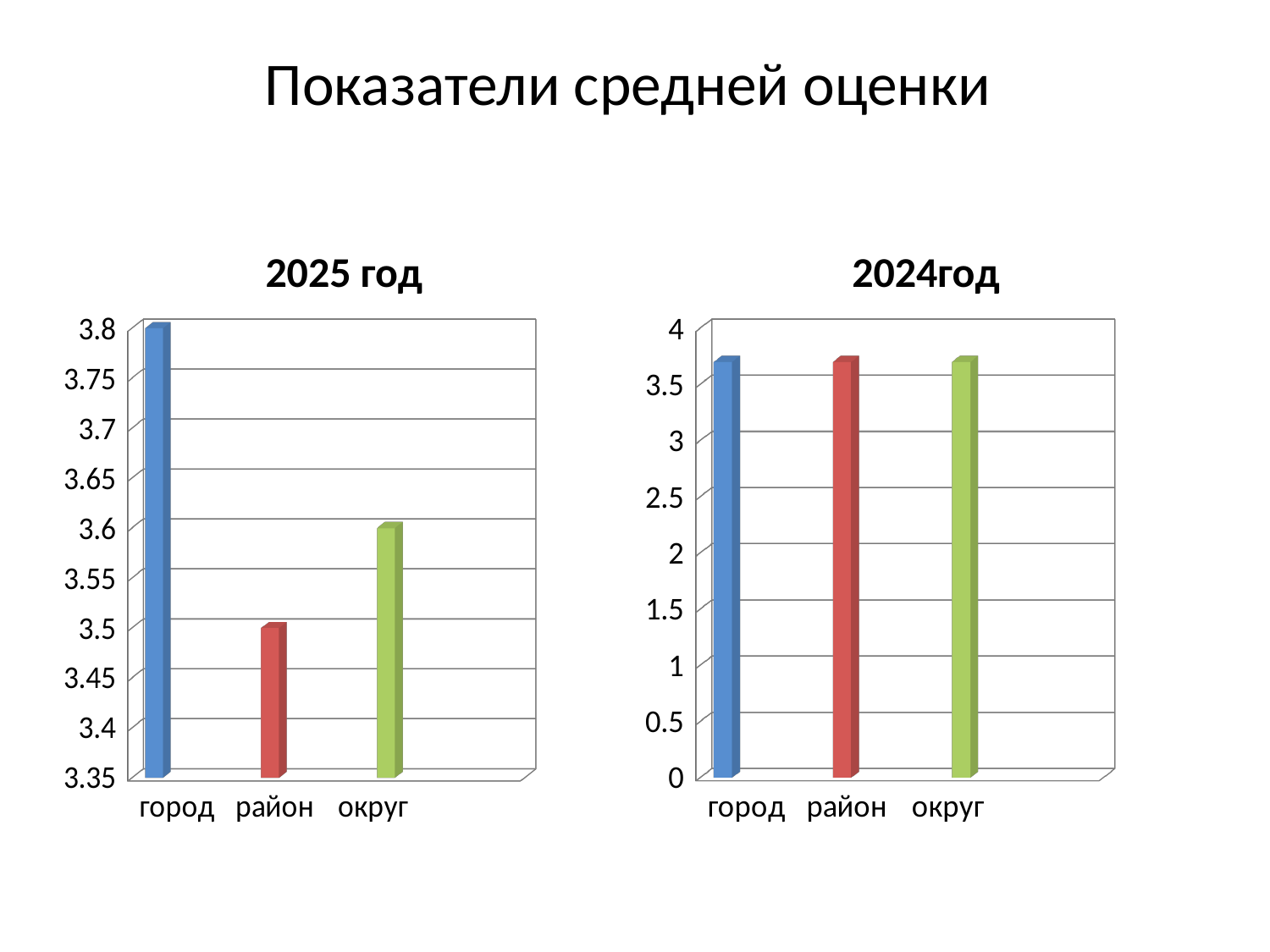
In the chart titled "2025 год", what is the value for город? 3.8 How many categories are shown in the chart titled "2024год"? 3 In the chart titled "2025 год", what is the value for округ? 3.6 In the chart titled "2024год", is the value for округ greater or less than 4? less In the chart titled "2025 год", which category has the lowest value? район In the chart titled "2025 год", which category has the highest value? город In the chart titled "2024год", is the value for город greater or less than 3? greater In the chart titled "2025 год", which is larger, the value for округ or the value for район? округ What kind of chart is the chart titled "2025 год"? bar chart What is the title of the slide? Показатели средней оценки In the chart titled "2025 год", what is the value for район? 3.5 In the chart titled "2025 год", what is the difference between the values for город and район? 0.3